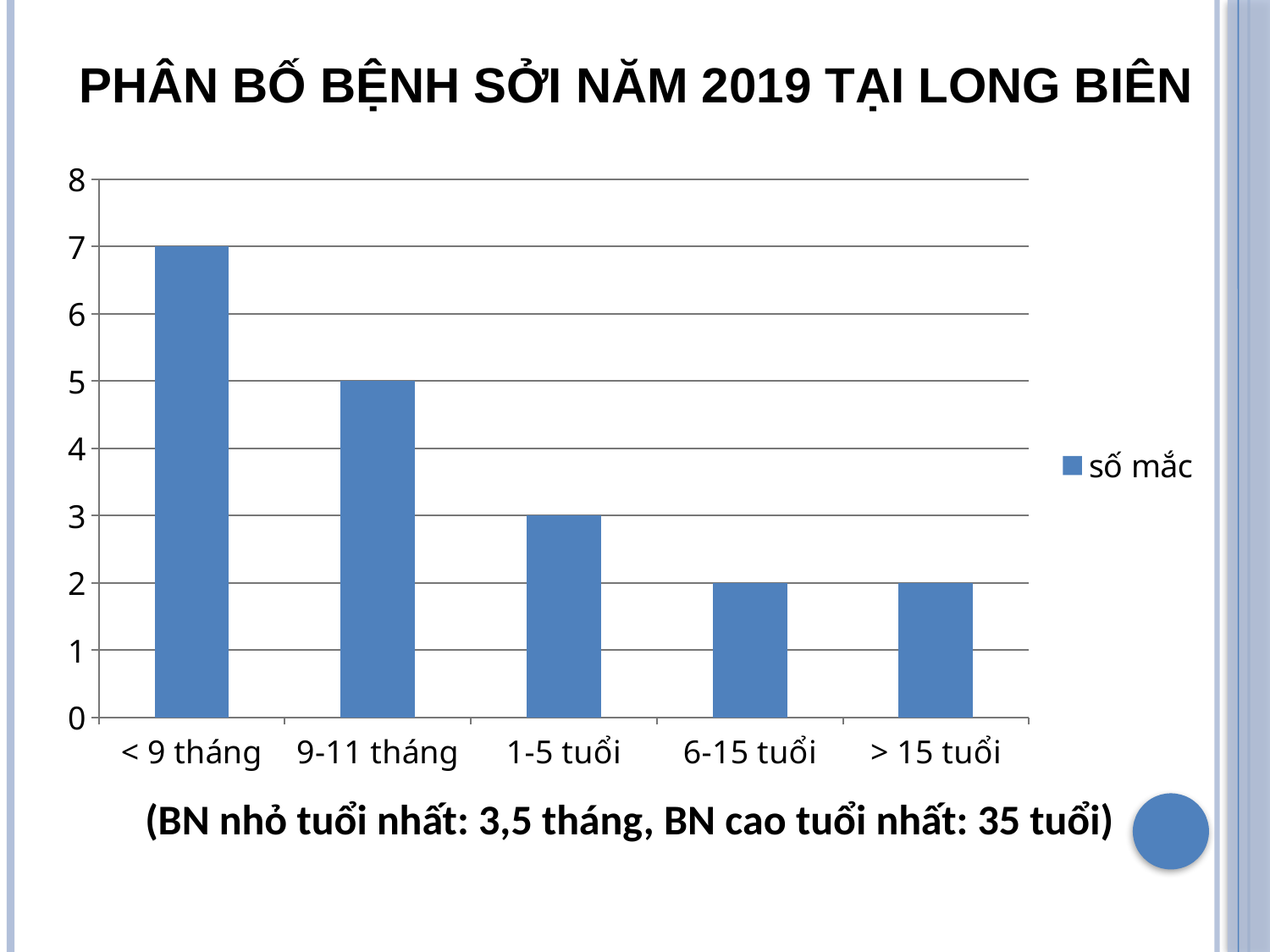
What is the difference between the values for < 9 tháng and 1-5 tuổi? 4 Which age group has the highest value? < 9 tháng How many age groups are shown on the x axis? 5 How many series does the legend list? 1 What is the value for 9-11 tháng? 5 Is the value for < 9 tháng greater or less than 6? greater What kind of chart is shown on the slide? bar chart What is the value for 6-15 tuổi? 2 What is the value for 1-5 tuổi? 3 What is the value for < 9 tháng? 7 What is the difference between the values for < 9 tháng and 9-11 tháng? 2 Which is larger, the value for 9-11 tháng or the value for 1-5 tuổi? 9-11 tháng